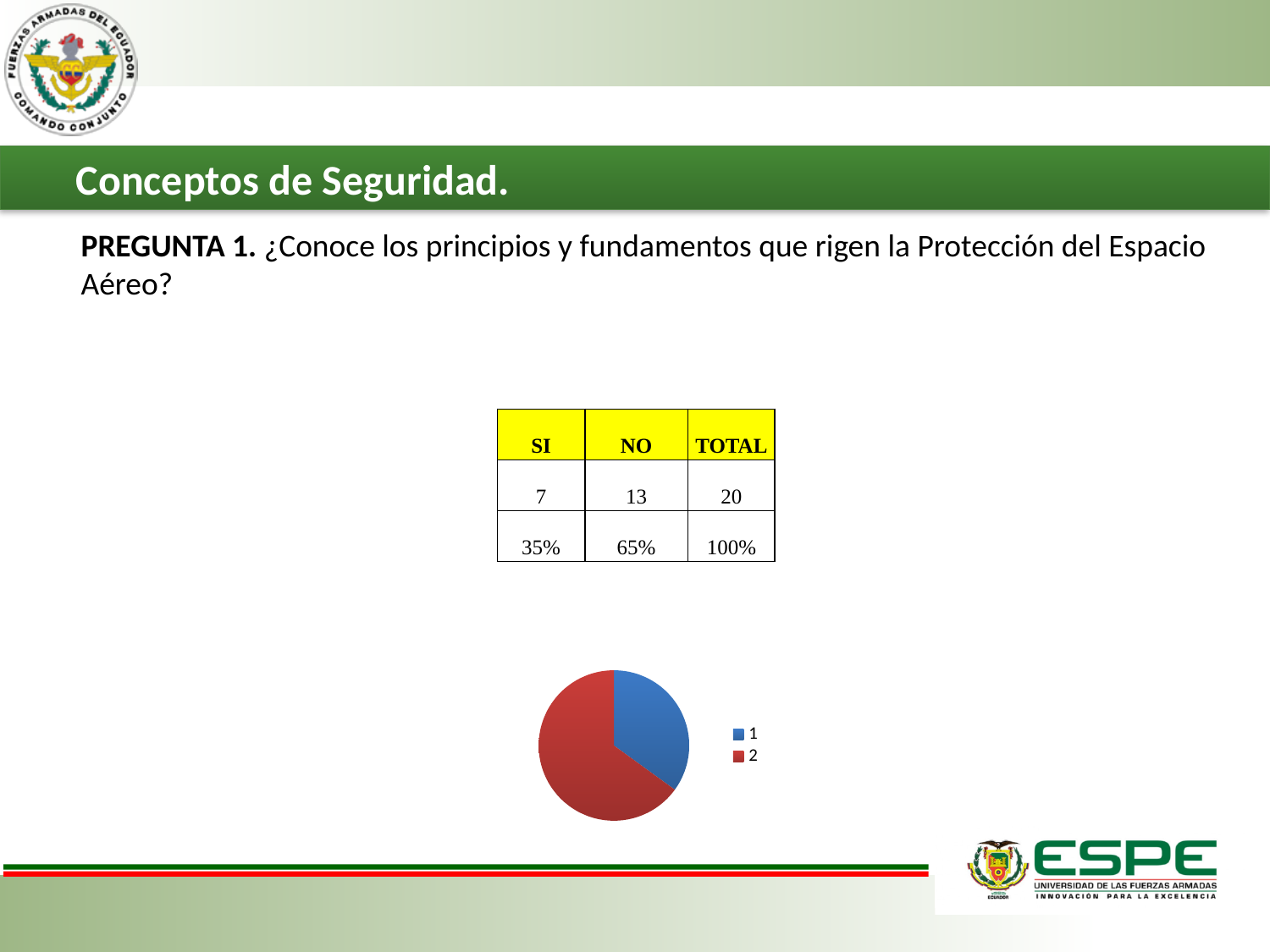
What colour is the slice for legend entry 1 in the pie chart? blue What kind of chart is shown on the slide? pie chart How many slices does the pie chart have? 2 Which legend entry corresponds to the smaller slice of the pie chart? 1 Is the slice labelled 1 or the slice labelled 2 larger in the pie chart? 2 Is the slice labelled 1 greater or less than half of the pie? less Is the slice labelled 2 greater or less than half of the pie? greater Which legend entry corresponds to the larger slice of the pie chart? 2 What colour is the slice for legend entry 2 in the pie chart? red How many entries does the legend of the pie chart list? 2